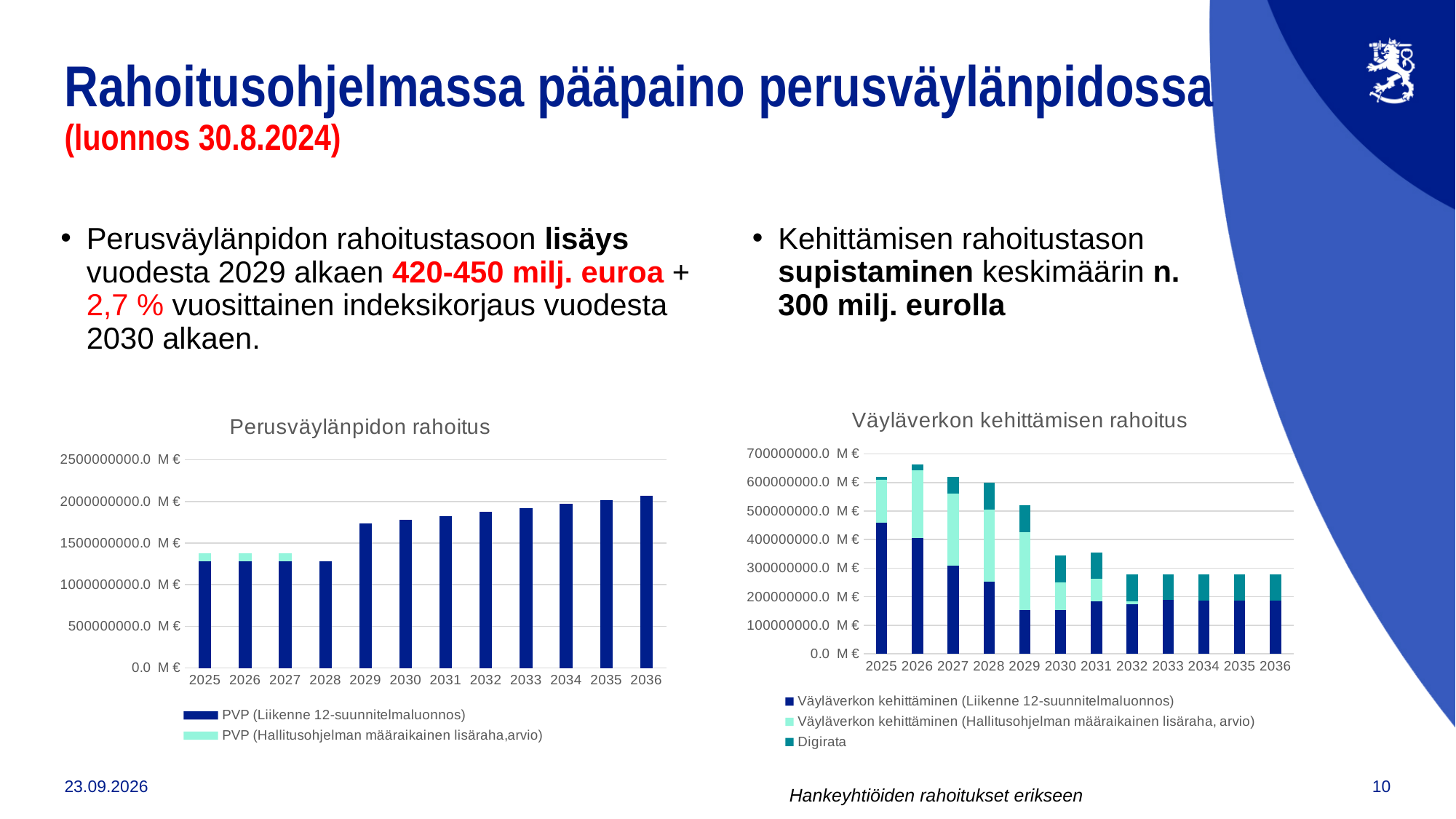
In the "Perusväylänpidon rahoitus" chart, is the value for 2029 greater or less than 1500000000.0 M €? greater In the "Väyläverkon kehittämisen rahoitus" chart, which year has the tallest stacked bar? 2026 In the "Perusväylänpidon rahoitus" chart, do the values generally rise or fall from 2028 to 2036? rise How many series does the legend of the "Väyläverkon kehittämisen rahoitus" chart list? 3 In the "Perusväylänpidon rahoitus" chart, is the value for 2028 greater or less than 1500000000.0 M €? less What kind of chart is the "Perusväylänpidon rahoitus" chart? bar chart In the "Väyläverkon kehittämisen rahoitus" chart, is the total for 2030 greater or less than 400000000.0 M €? less In the "Perusväylänpidon rahoitus" chart, which year has the highest bar? 2036 How many years are shown on the x axis of the "Perusväylänpidon rahoitus" chart? 12 How many series does the legend of the "Perusväylänpidon rahoitus" chart list? 2 In the "Väyläverkon kehittämisen rahoitus" chart, do the stacked bar totals generally rise or fall from 2026 to 2036? fall In the "Väyläverkon kehittämisen rahoitus" chart, which series is shown in the darkest blue colour? Väyläverkon kehittäminen (Liikenne 12-suunnitelmaluonnos)